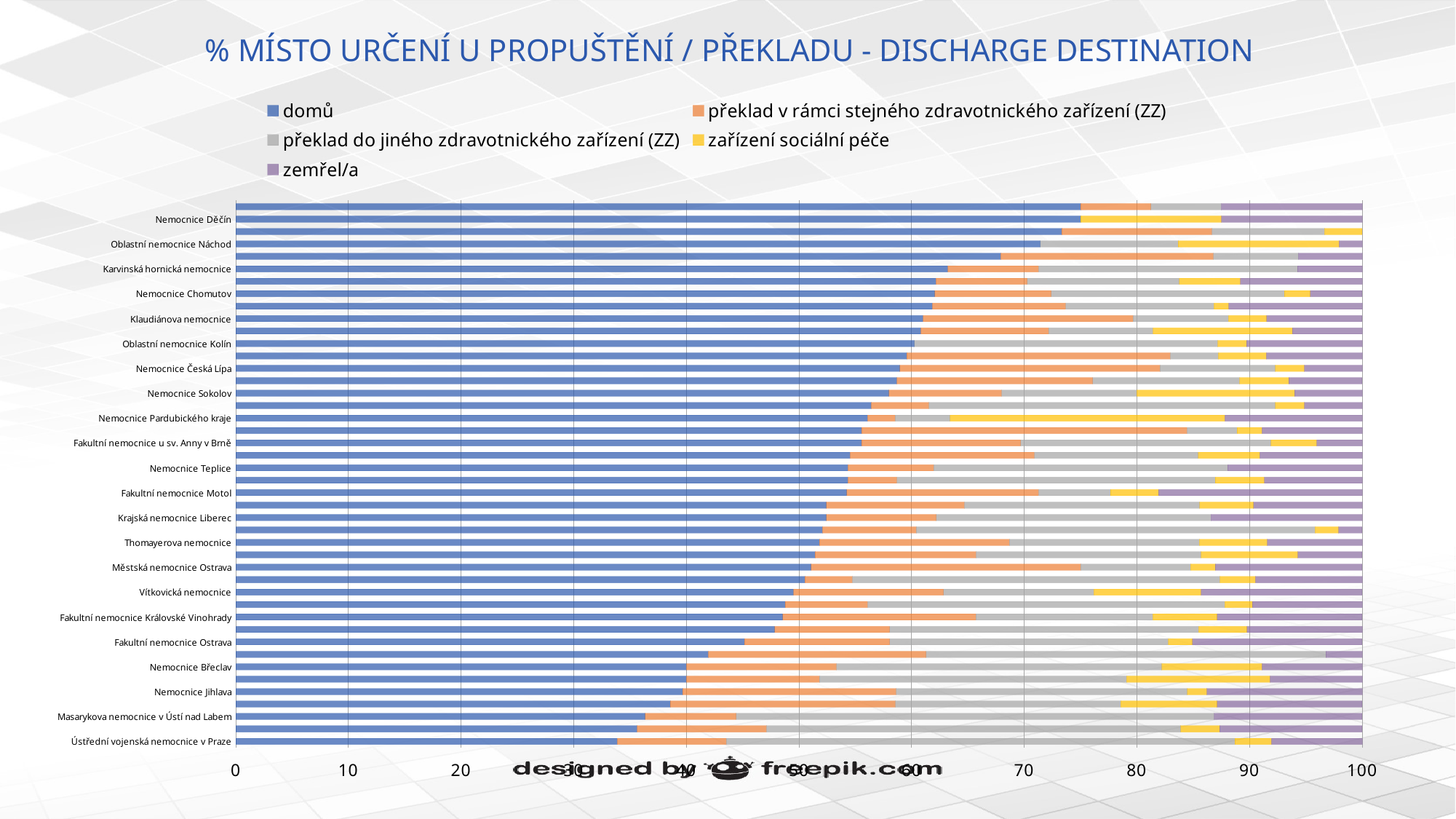
Is the "domů" value for Masarykova nemocnice v Ústí nad Labem greater or less than 40? less Is the "domů" value for Nemocnice Děčín greater or less than 70? greater Which colour represents the series "domů" in the chart? Blue Is the "domů" value for Ústřední vojenská nemocnice v Praze greater or less than 40? less What kind of chart is shown on the slide? Stacked bar chart What is the maximum value shown on the horizontal axis? 100 What is the title of the chart? % MÍSTO URČENÍ U PROPUŠTĚNÍ / PŘEKLADU - DISCHARGE DESTINATION Which has a larger "domů" share: Nemocnice Děčín or Ústřední vojenská nemocnice v Praze? Nemocnice Děčín Which has a larger "domů" share: Nemocnice Chomutov or Nemocnice Jihlava? Nemocnice Chomutov How many series does the legend list? 5